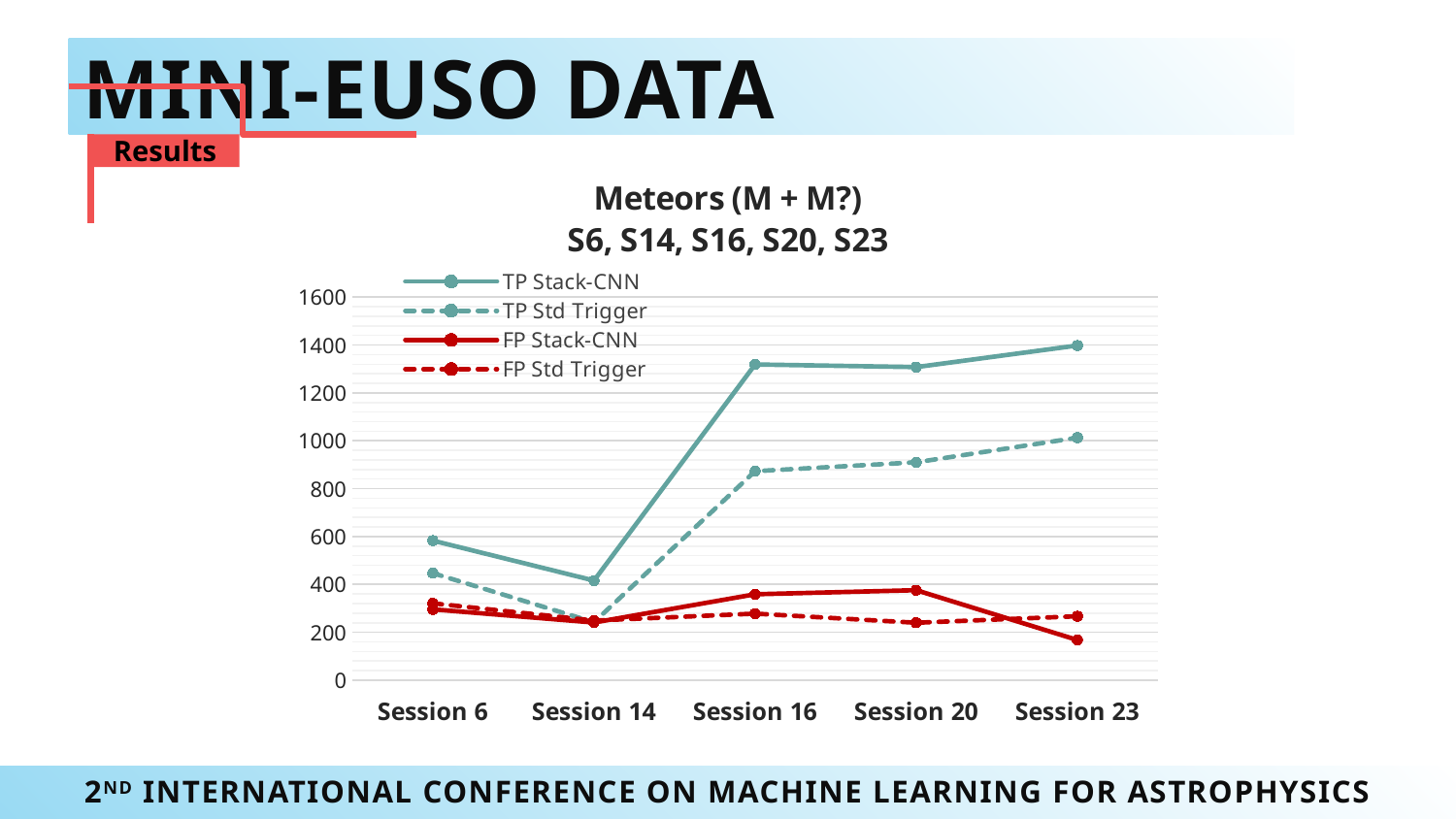
Which session has the highest value for TP Std Trigger? Session 23 How many series does the legend list? 4 What kind of chart is shown on the slide? line chart Which session has the highest value for TP Stack-CNN? Session 23 Is the value for FP Stack-CNN at Session 23 greater or less than 200? less Is the value for TP Stack-CNN at Session 16 greater or less than 1200? greater At Session 6, which is larger: TP Stack-CNN or TP Std Trigger? TP Stack-CNN Does the TP Std Trigger series rise or fall from Session 16 to Session 23? rise Which session has the lowest value for FP Stack-CNN? Session 23 Which session has the lowest value for TP Stack-CNN? Session 14 How many sessions are plotted along the x axis? 5 At Session 20, which is larger: FP Stack-CNN or FP Std Trigger? FP Stack-CNN